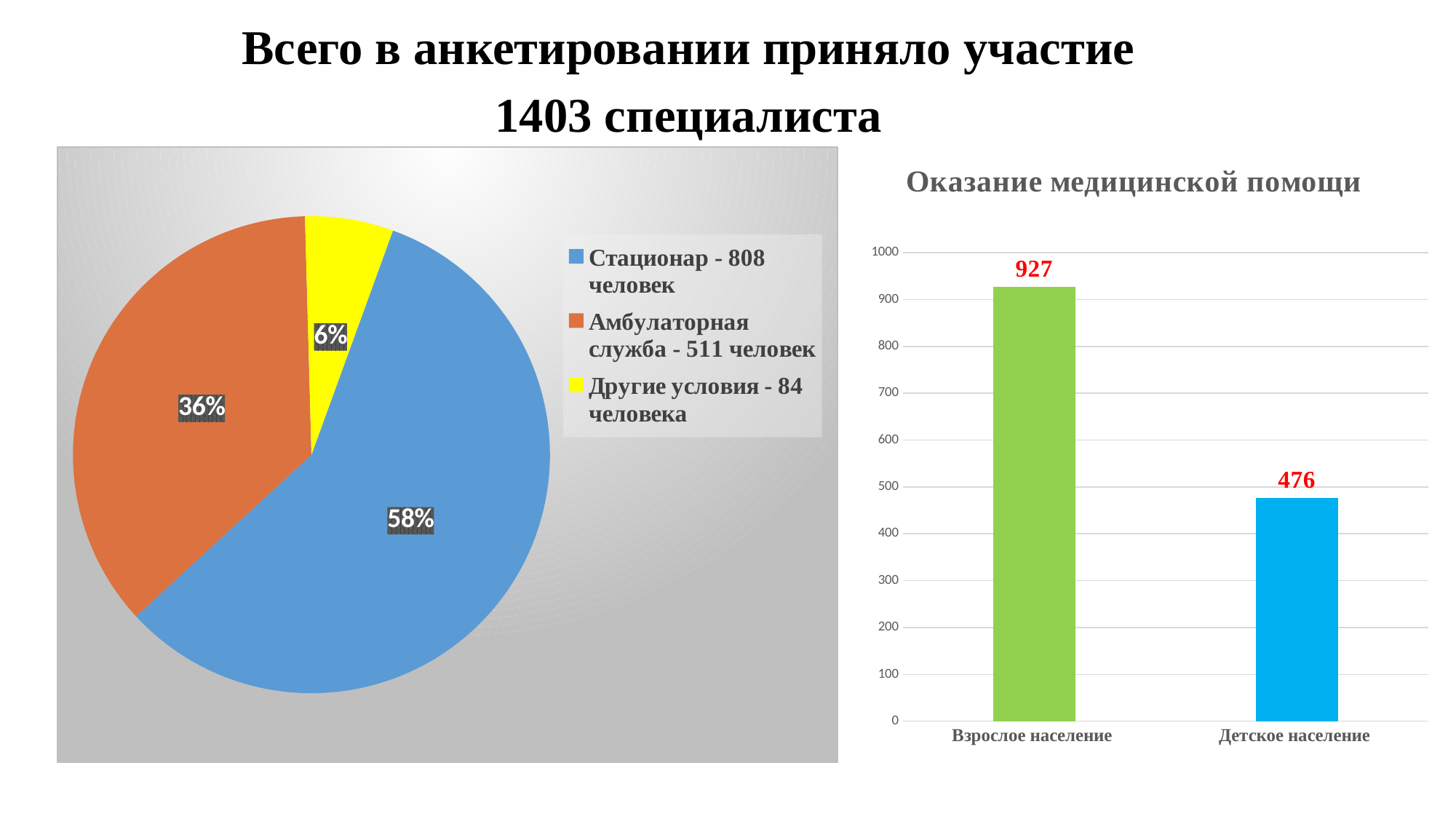
In the chart titled 'Оказание медицинской помощи', what is the difference between the values for Взрослое население and Детское население? 451 In the pie chart on the left, which category has the largest slice? Стационар In the pie chart on the left, what share of the pie does the Амбулаторная служба slice represent? 36% What kind of chart is the chart titled 'Оказание медицинской помощи'? Bar chart In the pie chart on the left, what share of the pie does the Стационар slice represent? 58% In the pie chart on the left, how many slices does the pie have? 3 In the pie chart on the left, what share of the pie does the Другие условия slice represent? 6% In the pie chart on the left, which category has the smallest slice? Другие условия In the chart titled 'Оказание медицинской помощи', what is the value for Детское население? 476 In the chart titled 'Оказание медицинской помощи', what is the value for Взрослое население? 927 In the chart titled 'Оказание медицинской помощи', which is larger: Взрослое население or Детское население? Взрослое население In the pie chart on the left, what colour is the Другие условия slice? Yellow